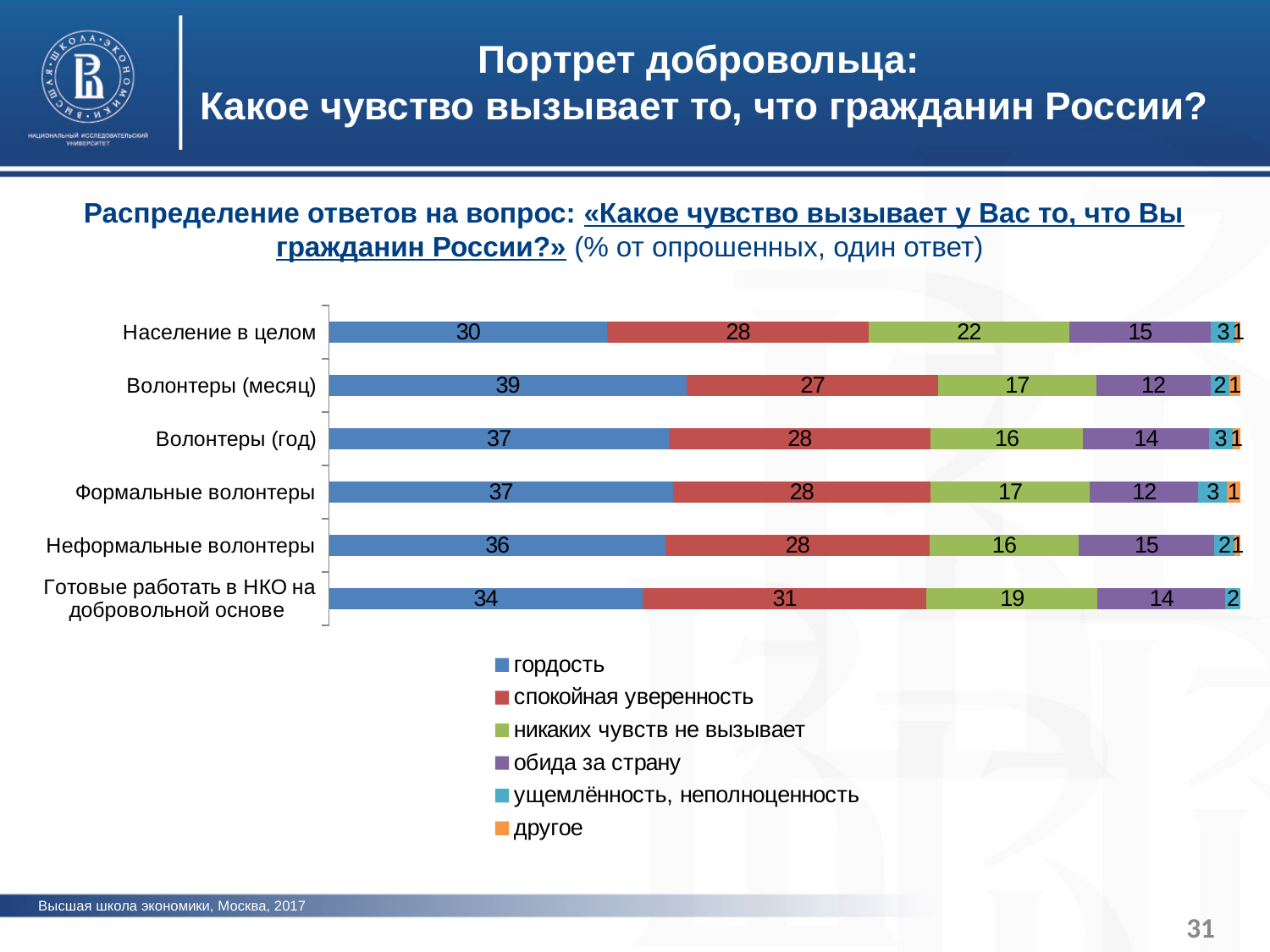
Which category has the highest value for 'гордость'? Волонтеры (месяц) Which is larger: the 'никаких чувств не вызывает' value for 'Население в целом' or for 'Формальные волонтеры'? Население в целом How many series does the legend list? 6 What percentage of 'Население в целом' answered 'гордость'? 30 What is the value for 'спокойная уверенность' among 'Готовые работать в НКО на добровольной основе'? 31 Which legend entry is shown in green? никаких чувств не вызывает What is the value for 'никаких чувств не вызывает' for 'Волонтеры (год)'? 16 What is the difference between the 'гордость' values for 'Волонтеры (месяц)' and 'Население в целом'? 9 What is the total of the stacked bar for 'Население в целом'? 99 What type of chart is shown on the slide? Stacked bar chart Which category has the lowest value for 'гордость'? Население в целом How many categories (groups) are shown on the chart? 6